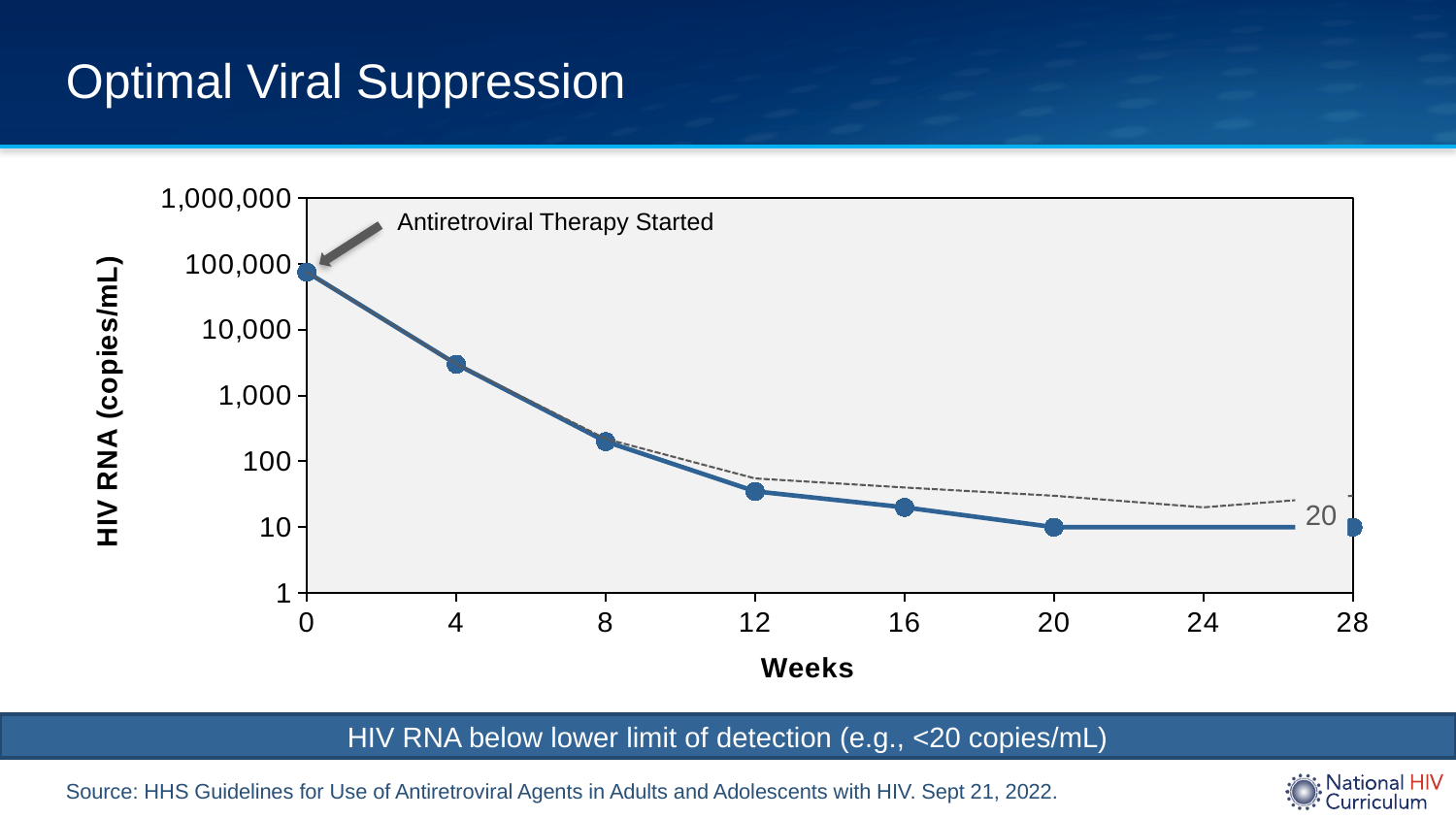
Which has the larger HIV RNA value, week 8 or week 20? week 8 What is the label of the y axis? HIV RNA (copies/mL) What is the title of the chart on the slide? Optimal Viral Suppression Is the HIV RNA value at week 4 greater or less than 10,000? less Is the HIV RNA value at week 8 greater or less than 1,000? less Is the HIV RNA value at week 12 greater or less than 100? less At which week is the HIV RNA value highest? 0 Which has the larger HIV RNA value, week 4 or week 12? week 4 What kind of chart is shown on the slide? line chart Do the HIV RNA values rise or fall as the weeks increase? fall